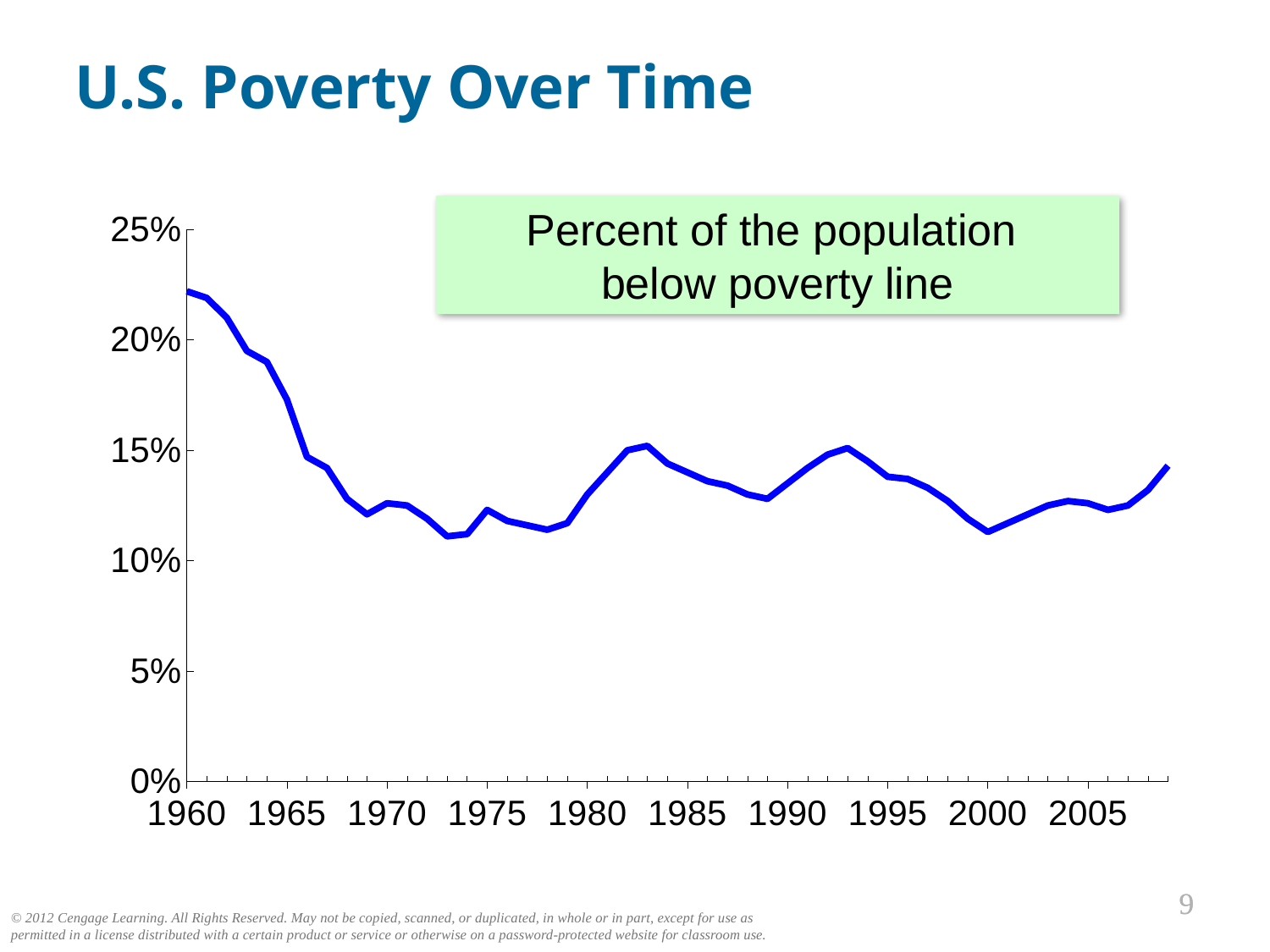
Is the value for 1970 greater or less than 15%? less Is the value for 2000 greater or less than 15%? less Is the value for 1960 greater or less than 20%? greater What kind of chart is shown on the slide? line chart Which year has the larger poverty rate, 1965 or 1975? 1965 Which year has the larger poverty rate, 1960 or 2000? 1960 According to the label box on the chart, what does the plotted line measure? Percent of the population below poverty line What is the title of the chart on the slide? U.S. Poverty Over Time In which year shown on the x axis is the poverty rate highest? 1960 Does the poverty rate rise or fall between 1960 and 1970? fall